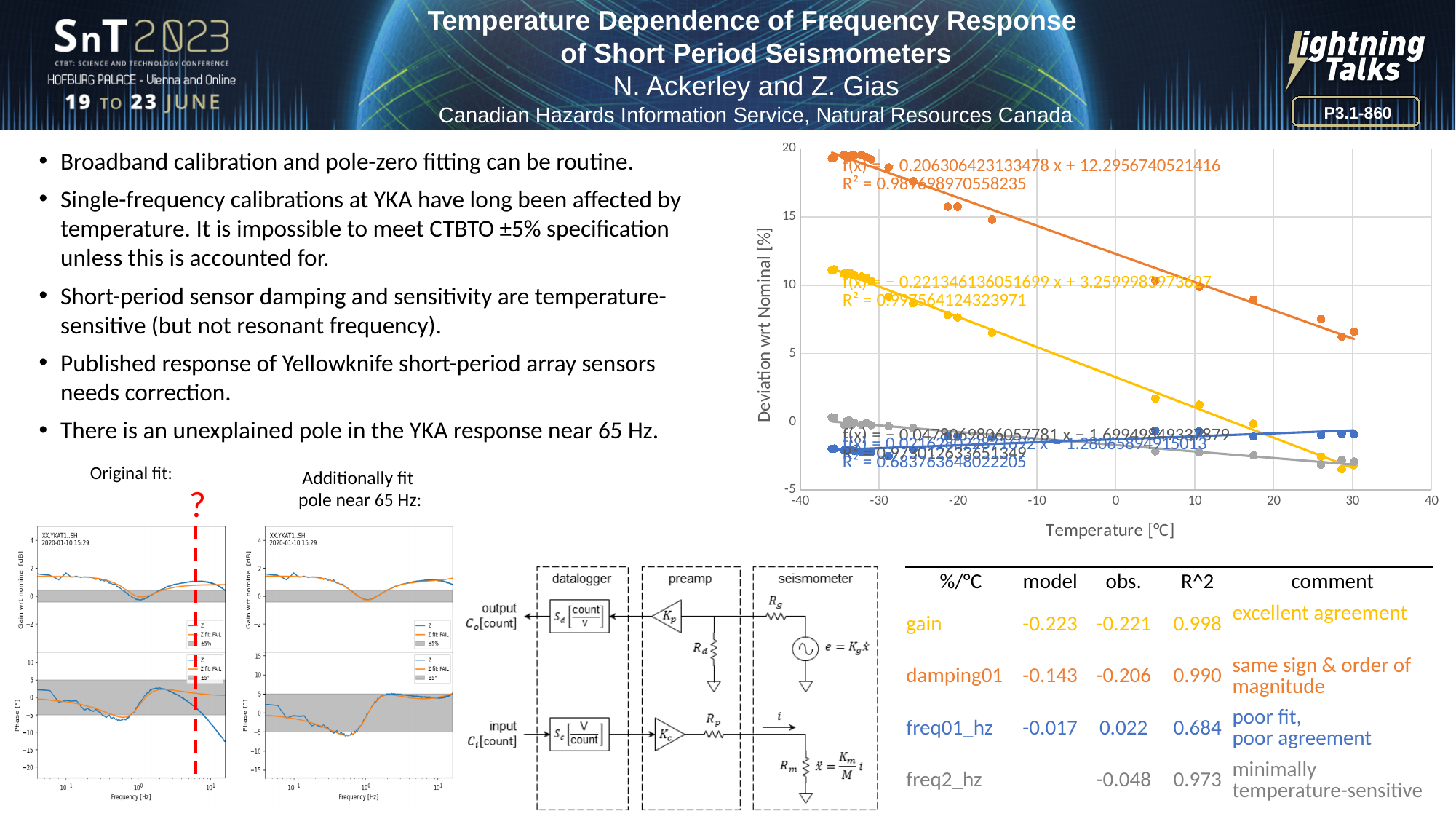
What is the y-axis title of the scatter chart? Deviation wrt Nominal [%] In the scatter chart, does the orange series rise or fall as temperature increases? fall In the scatter chart, is the yellow series value near 30 °C greater or less than 0? less In the scatter chart, does the yellow series rise or fall as temperature increases? fall How many data series are plotted in the scatter chart? 4 What kind of chart is the plot of Deviation wrt Nominal versus Temperature? scatter chart with trend lines In the scatter chart, which series has the higher deviation near 30 °C, the blue or the gray series? blue What is the R² value printed for the yellow trend line in the scatter chart? 0.997564124323971 In the scatter chart, is the orange series value near 30 °C greater or less than 5? greater In the scatter chart, which series has the higher deviation near -35 °C, the orange or the yellow series? orange In the scatter chart, is the orange series value near -35 °C greater or less than 15? greater What is the x-axis title of the scatter chart? Temperature [°C]